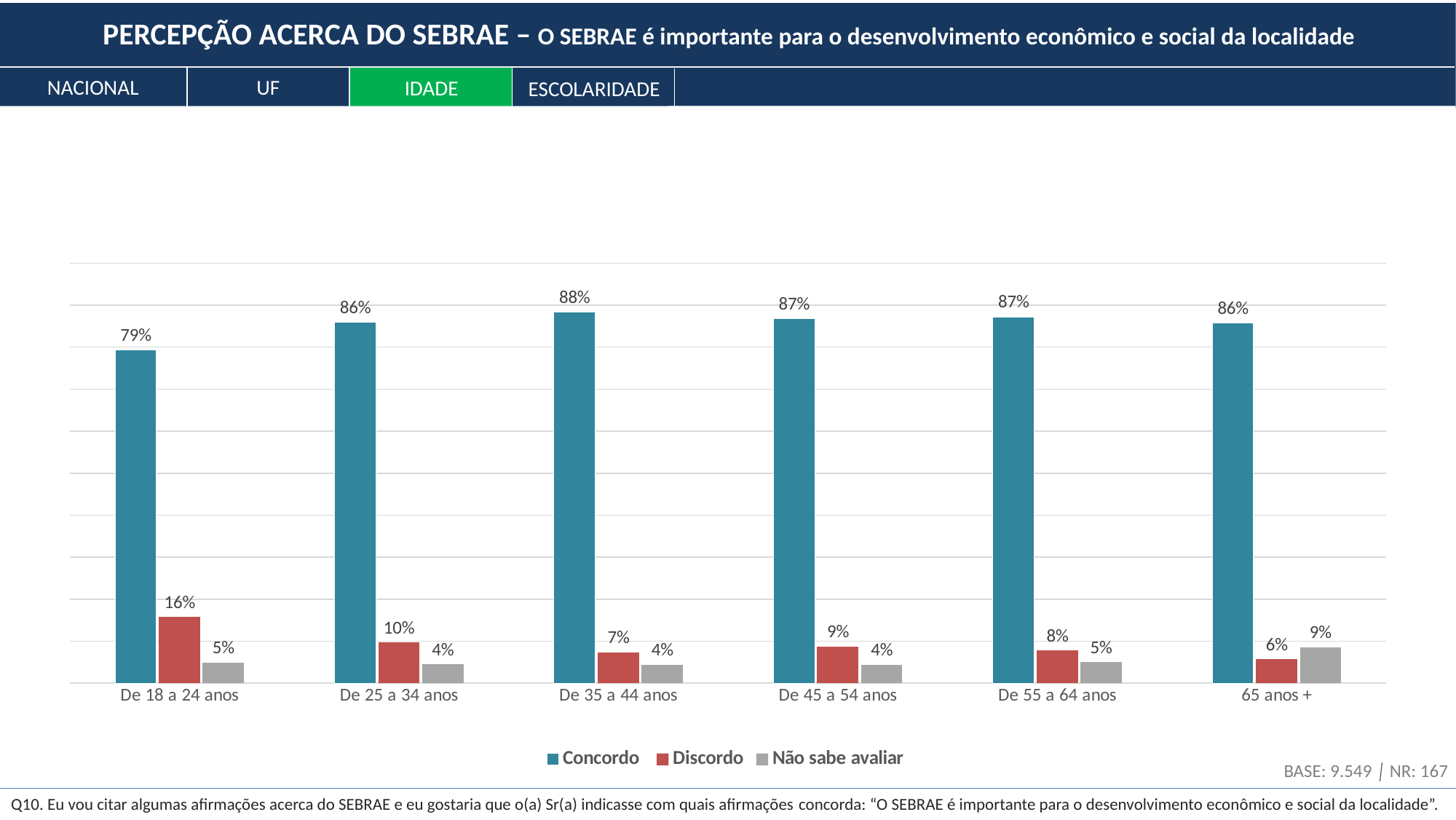
How many age groups are shown on the x axis? 6 What is the difference between the Concordo values for De 35 a 44 anos and De 18 a 24 anos? 9% Which age group has the lowest Concordo value? De 18 a 24 anos Which is larger for 65 anos +: Discordo or Não sabe avaliar? Não sabe avaliar Which age group has the highest Concordo value? De 35 a 44 anos What is the Não sabe avaliar value for 65 anos +? 9% What kind of chart is shown on the slide? Bar chart Which age group has the highest Discordo value? De 18 a 24 anos What is the Discordo value for De 25 a 34 anos? 10% What is the Concordo value for De 18 a 24 anos? 79% Which tab is highlighted in green above the chart? IDADE How many series does the legend list? 3